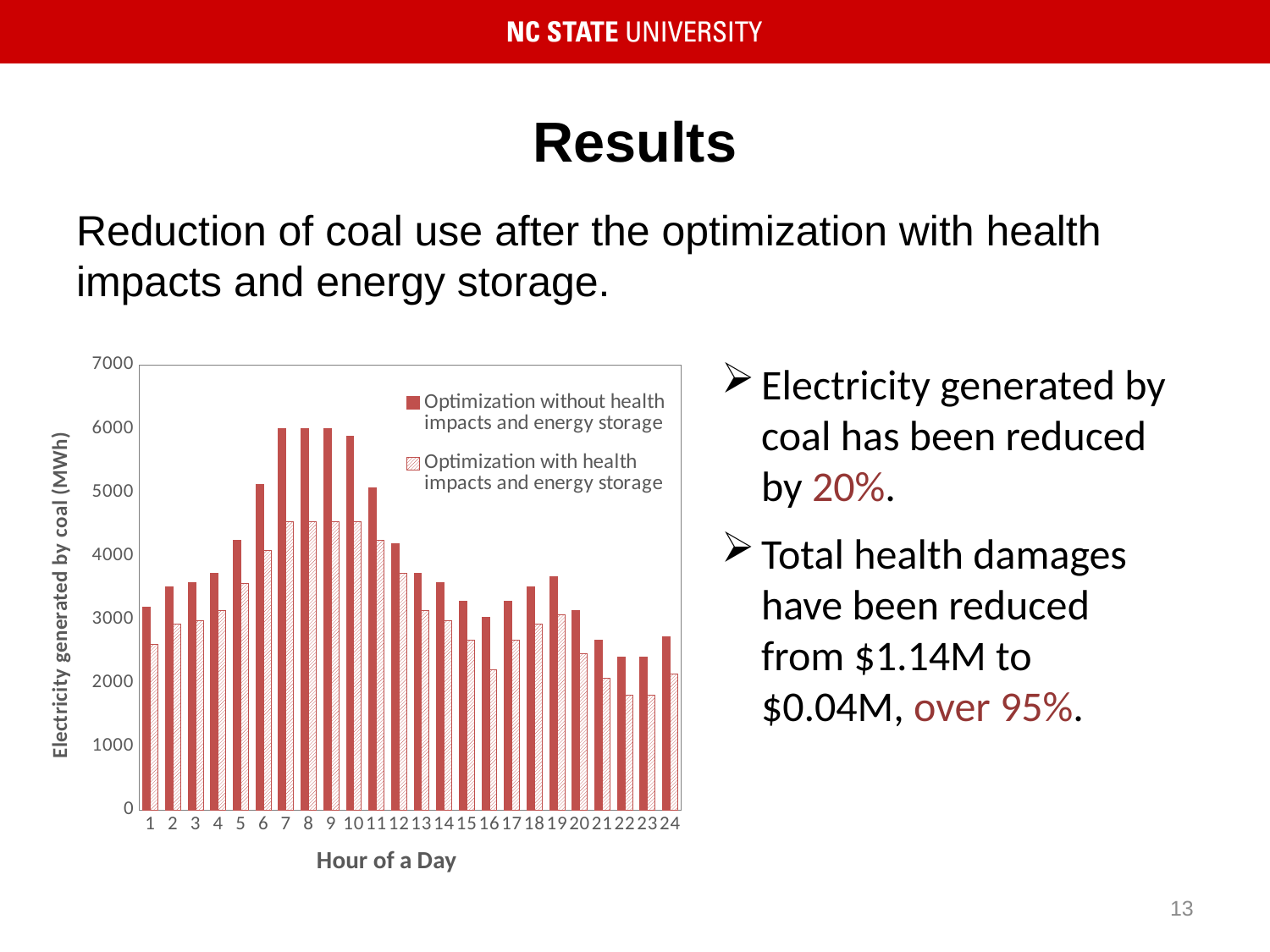
At hour 8, which series has the larger value: 'Optimization without health impacts and energy storage' or 'Optimization with health impacts and energy storage'? Optimization without health impacts and energy storage What kind of chart is shown on the slide? Bar chart In the 'Optimization without health impacts and energy storage' series, which hour has the larger value: hour 7 or hour 16? Hour 7 In the 'Optimization without health impacts and energy storage' series, do the values rise or fall from hour 9 to hour 16? Fall How many series does the chart legend list? 2 Is the value for hour 22 in the 'Optimization with health impacts and energy storage' series greater or less than 2000? less Is the value for hour 7 in the 'Optimization without health impacts and energy storage' series greater or less than 5000? greater What is the title of the chart's y axis? Electricity generated by coal (MWh) How many hours are plotted along the x axis of the chart? 24 Is the value for hour 12 in the 'Optimization with health impacts and energy storage' series greater or less than 3000? greater What is the title of the chart's x axis? Hour of a Day